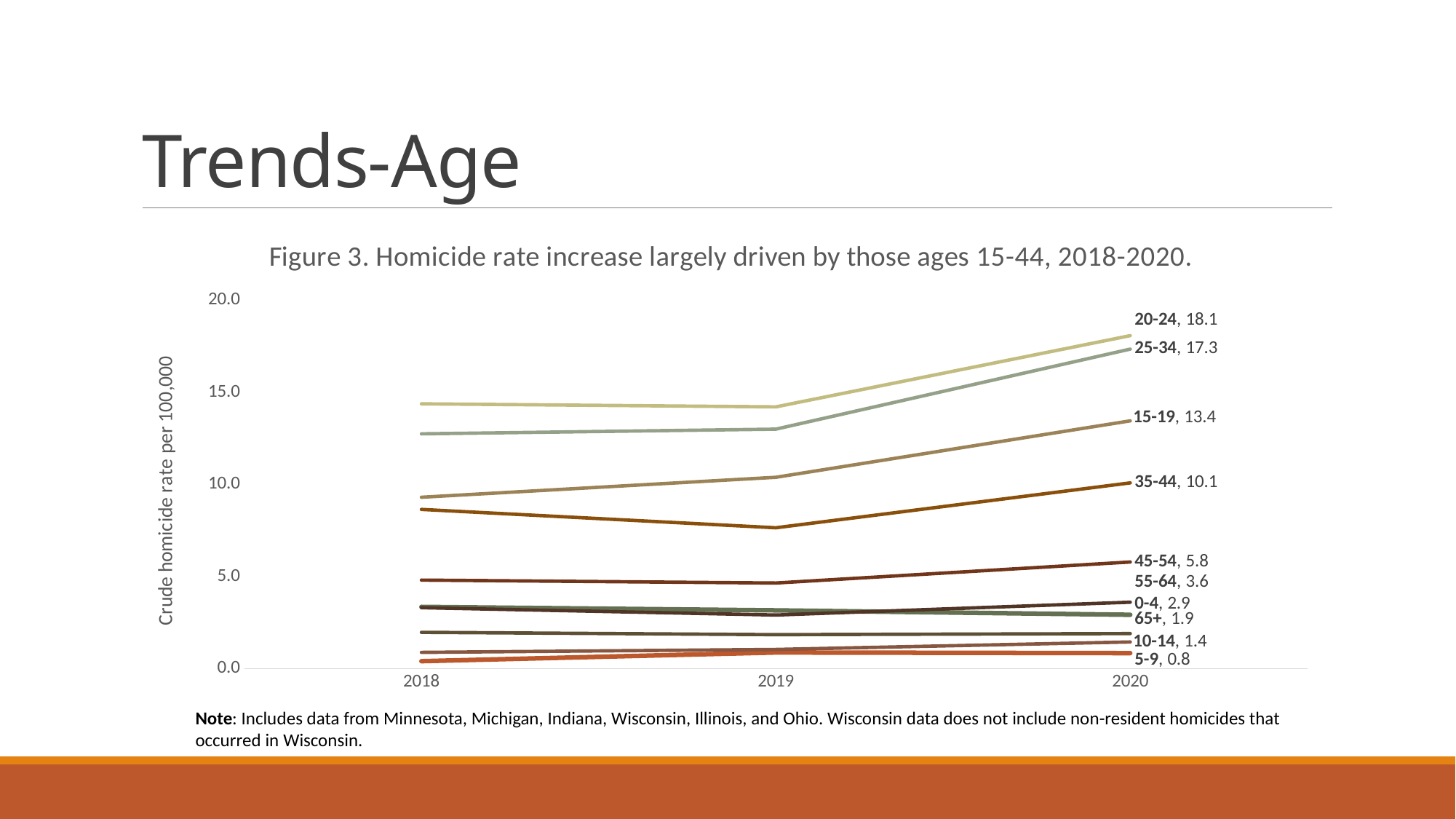
Which age group has the highest homicide rate in 2020? 20-24 Does the homicide rate for the 25-34 age group rise or fall from 2019 to 2020? rise Which age group has the lowest homicide rate in 2020? 5-9 Is the 2018 value for the 20-24 age group greater or less than 15.0? less What is the difference between the 2020 rates for the 20-24 and 25-34 age groups? 0.8 How many age groups are plotted in the chart? 10 What is the crude homicide rate for the 20-24 age group in 2020? 18.1 What is the crude homicide rate for the 35-44 age group in 2020? 10.1 How many years are shown on the x axis? 3 What kind of chart is shown on the slide? line chart In 2020, which age group has the larger homicide rate, 15-19 or 35-44? 15-19 Is the 2019 value for the 35-44 age group greater or less than 10.0? less